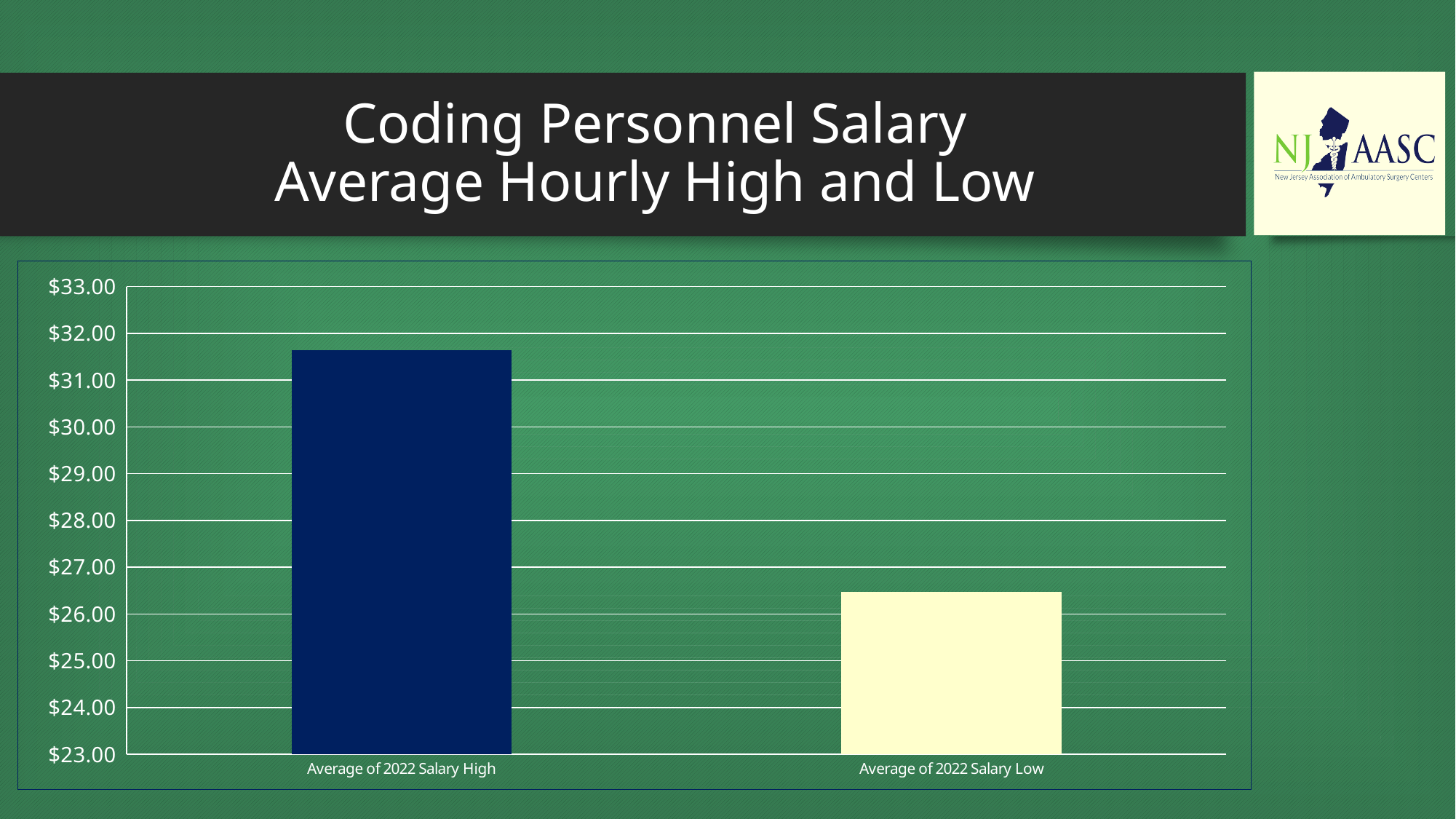
What is the lowest value shown on the vertical axis of the chart? $23.00 How many bars does the chart show? 2 Is the value for Average of 2022 Salary High greater or less than $31.00? greater Which category has the lowest value on the chart? Average of 2022 Salary Low Is the value for Average of 2022 Salary Low greater or less than $26.00? greater What kind of chart is shown on the slide? bar chart Which category has the higher value, Average of 2022 Salary High or Average of 2022 Salary Low? Average of 2022 Salary High Which category has the highest value on the chart? Average of 2022 Salary High What is the title of the slide containing the chart? Coding Personnel Salary Average Hourly High and Low Is the value for Average of 2022 Salary High greater or less than $32.00? less